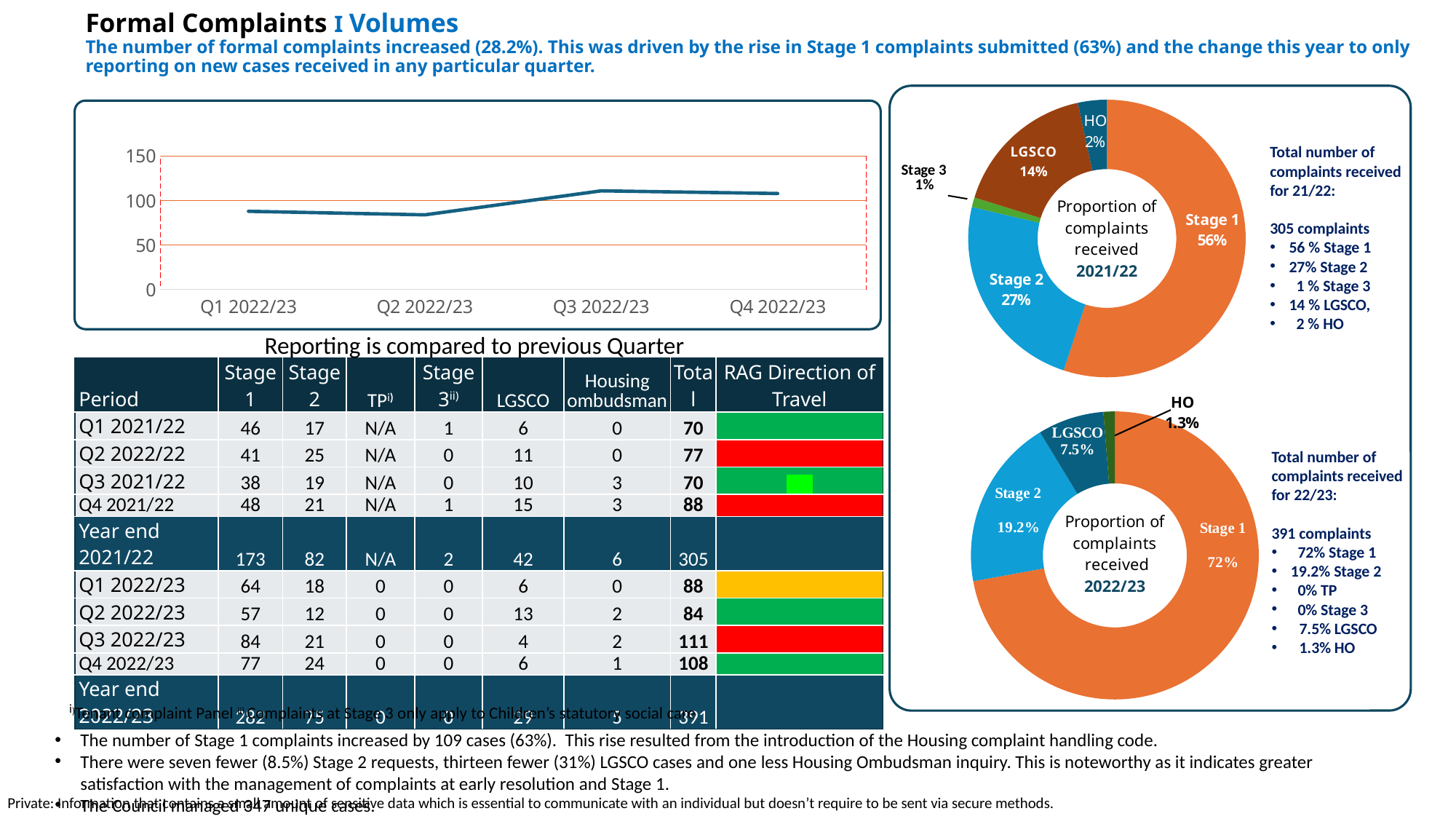
In the 'Proportion of complaints received 2021/22' donut chart, which category has the smallest share? Stage 3 In the line chart at the top left, is the value for Q3 2022/23 greater or less than 100? greater In the 'Proportion of complaints received 2022/23' donut chart, what is the difference between the Stage 1 share and the Stage 2 share? 52.8% In the line chart at the top left, is the value for Q1 2022/23 greater or less than 100? less In the 'Proportion of complaints received 2021/22' donut chart, what share is LGSCO? 14% In the 'Proportion of complaints received 2022/23' donut chart, what share is Stage 2? 19.2% In the 'Proportion of complaints received 2021/22' donut chart, what share is Stage 1? 56% In the 'Proportion of complaints received 2022/23' donut chart, which category has the largest share? Stage 1 In the line chart at the top left, how many quarters are plotted along the x axis? 4 In the line chart at the top left, does the line rise or fall between Q2 2022/23 and Q3 2022/23? rise What kind of chart is the chart at the top left of the slide showing Q1 2022/23 to Q4 2022/23? line chart Comparing the two donut charts, is the Stage 1 share larger in 2021/22 or in 2022/23? 2022/23